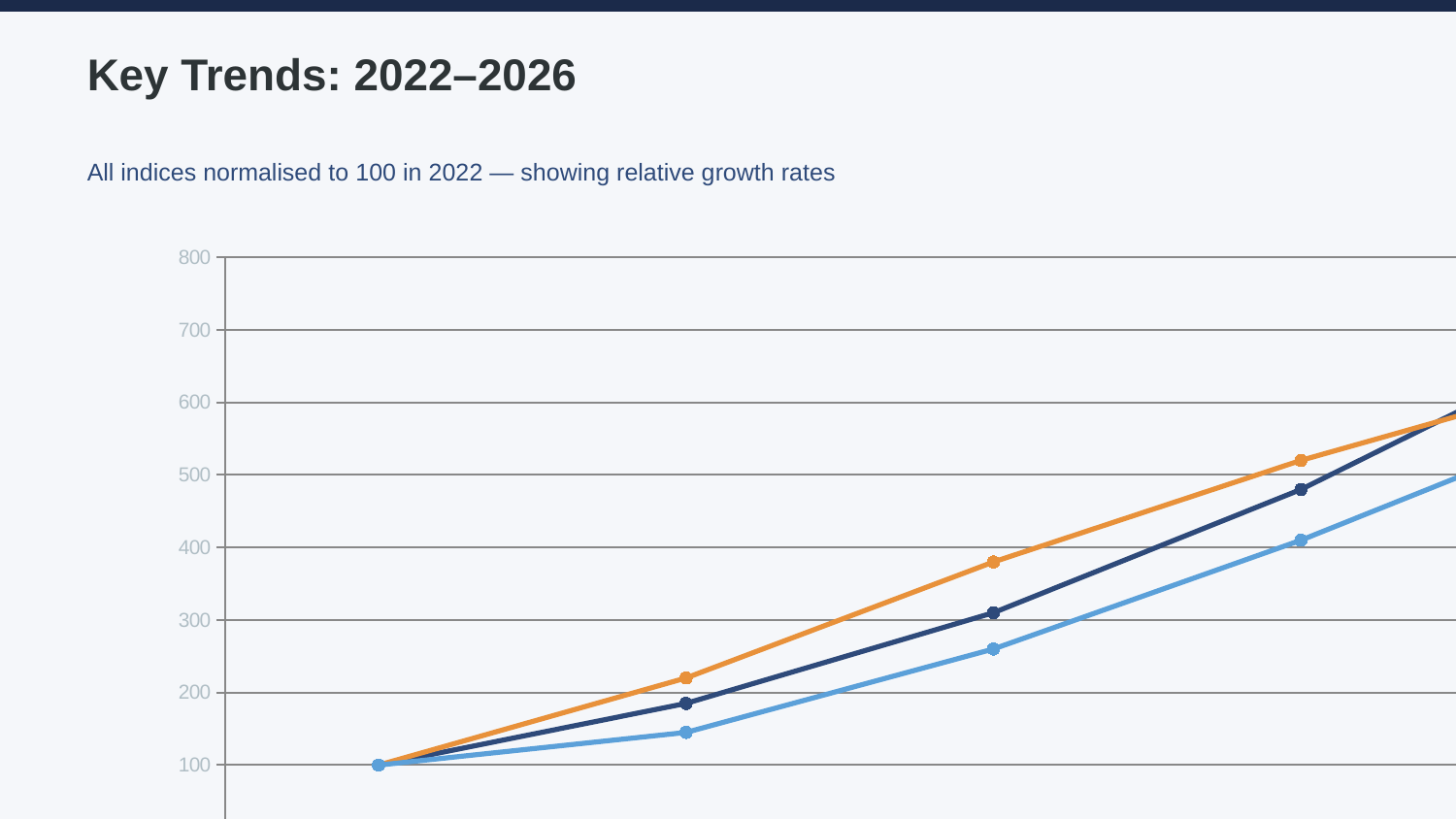
Is the value of the orange line at its fourth plotted point from the left greater or less than 400? greater Is the value of the dark blue line at its third plotted point from the left greater or less than 200? greater Which line is lowest at the fourth plotted point from the left? the light blue line Do the plotted values rise or fall from left to right along the x axis? rise What is the highest value labelled on the y axis? 800 Is the value of the light blue line at its second plotted point from the left greater or less than 200? less What value do all three lines start at in 2022? 100 What kind of chart is shown on the slide? line chart Which line is highest at the fourth plotted point from the left? the orange line What is the title of the slide containing the chart? Key Trends: 2022–2026 How many lines are plotted on the chart? 3